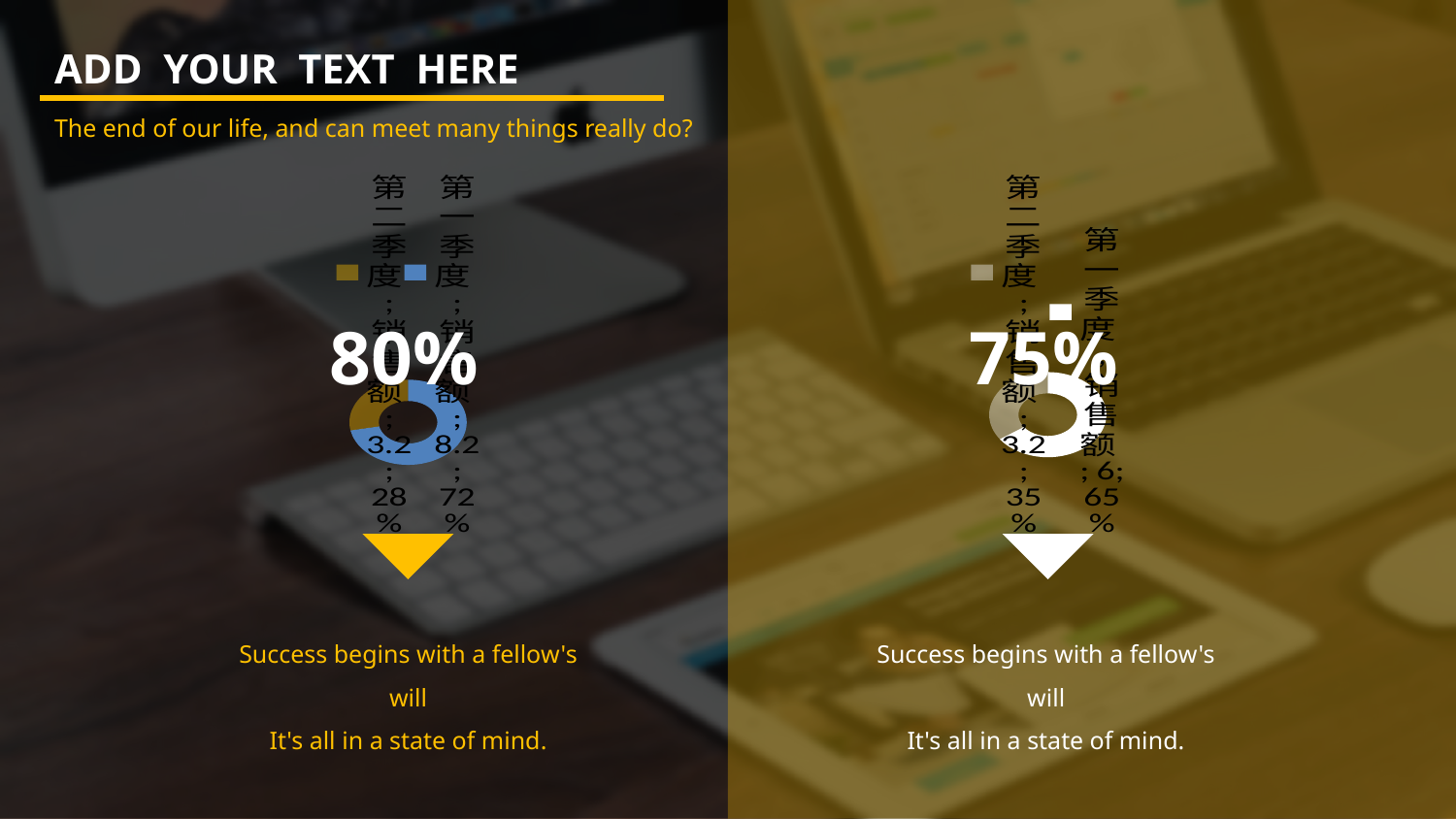
How many entries does the legend of the right chart list? 2 In the right chart, what percentage is shown for 第一季度? 65% What large percentage figure is overlaid on the left chart? 80% In the right chart, what percentage is shown for 第二季度? 35% How many slices does the left chart have? 2 In the right chart, which quarter has the smaller slice? 第二季度 In the left chart, what is the difference in percentage points between the 第一季度 and 第二季度 slices? 44 percentage points In the left chart, which quarter has the larger slice? 第一季度 In the left chart, what percentage is shown for 第二季度? 28% In the right chart, what is the difference in percentage points between the 第一季度 and 第二季度 slices? 30 percentage points What kind of chart is shown on the left side of the slide? doughnut chart